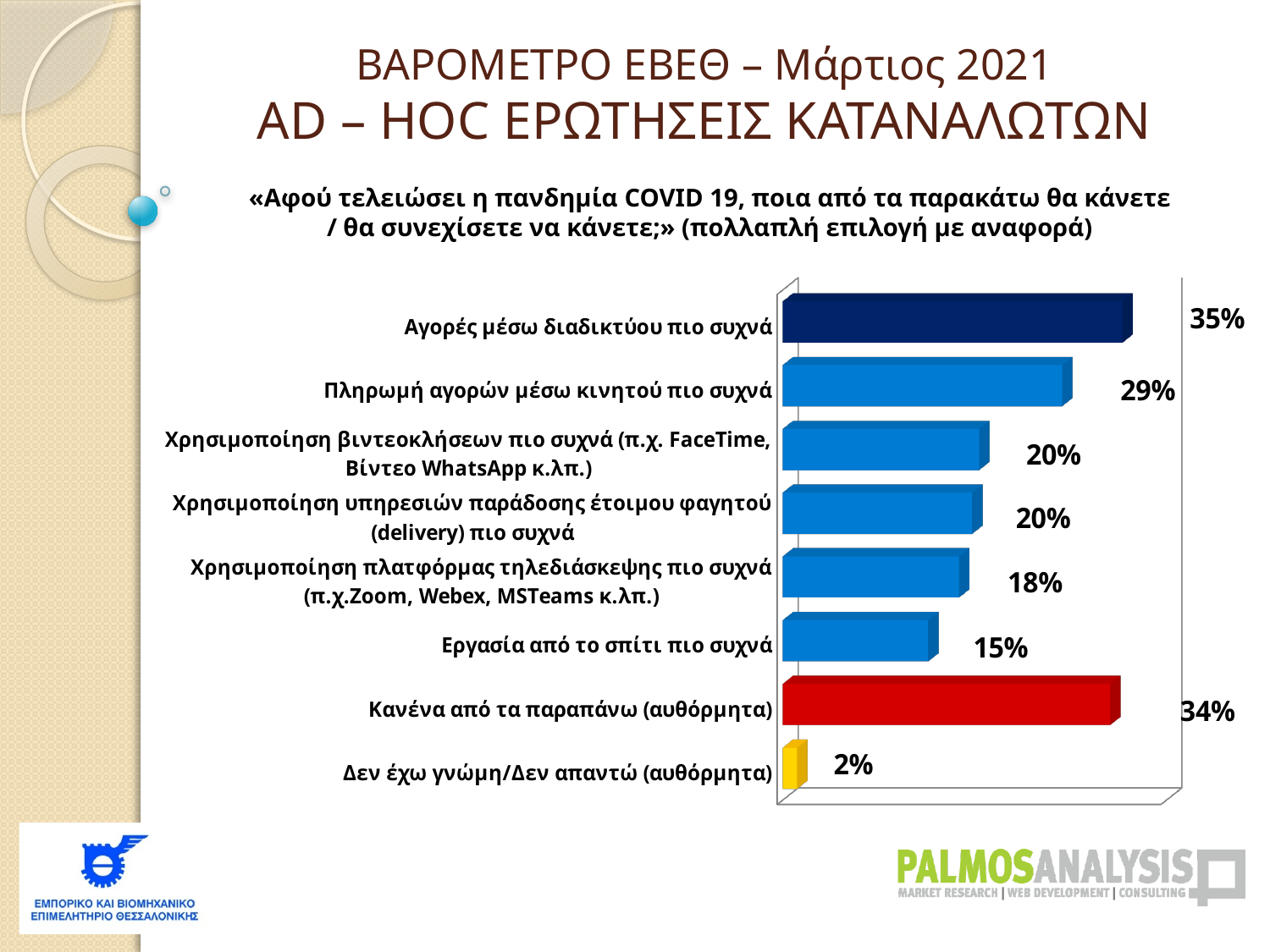
What is the value for "Πληρωμή αγορών μέσω κινητού πιο συχνά"? 29% What is the value for "Αγορές μέσω διαδικτύου πιο συχνά"? 35% Which category has the highest value? Αγορές μέσω διαδικτύου πιο συχνά What colour is the bar for "Κανένα από τα παραπάνω (αυθόρμητα)"? Red What kind of chart is shown on the slide? Bar chart Which is larger: the value for "Κανένα από τα παραπάνω (αυθόρμητα)" or the value for "Εργασία από το σπίτι πιο συχνά"? Κανένα από τα παραπάνω (αυθόρμητα) How many categories are shown in the chart? 8 What is the value for "Εργασία από το σπίτι πιο συχνά"? 15% What is the value for "Κανένα από τα παραπάνω (αυθόρμητα)"? 34% Which category has the lowest value? Δεν έχω γνώμη/Δεν απαντώ (αυθόρμητα) What is the value for "Χρησιμοποίηση πλατφόρμας τηλεδιάσκεψης πιο συχνά (π.χ.Zoom, Webex, MSTeams κ.λπ.)"? 18% What is the difference between the values for "Αγορές μέσω διαδικτύου πιο συχνά" and "Πληρωμή αγορών μέσω κινητού πιο συχνά"? 6%